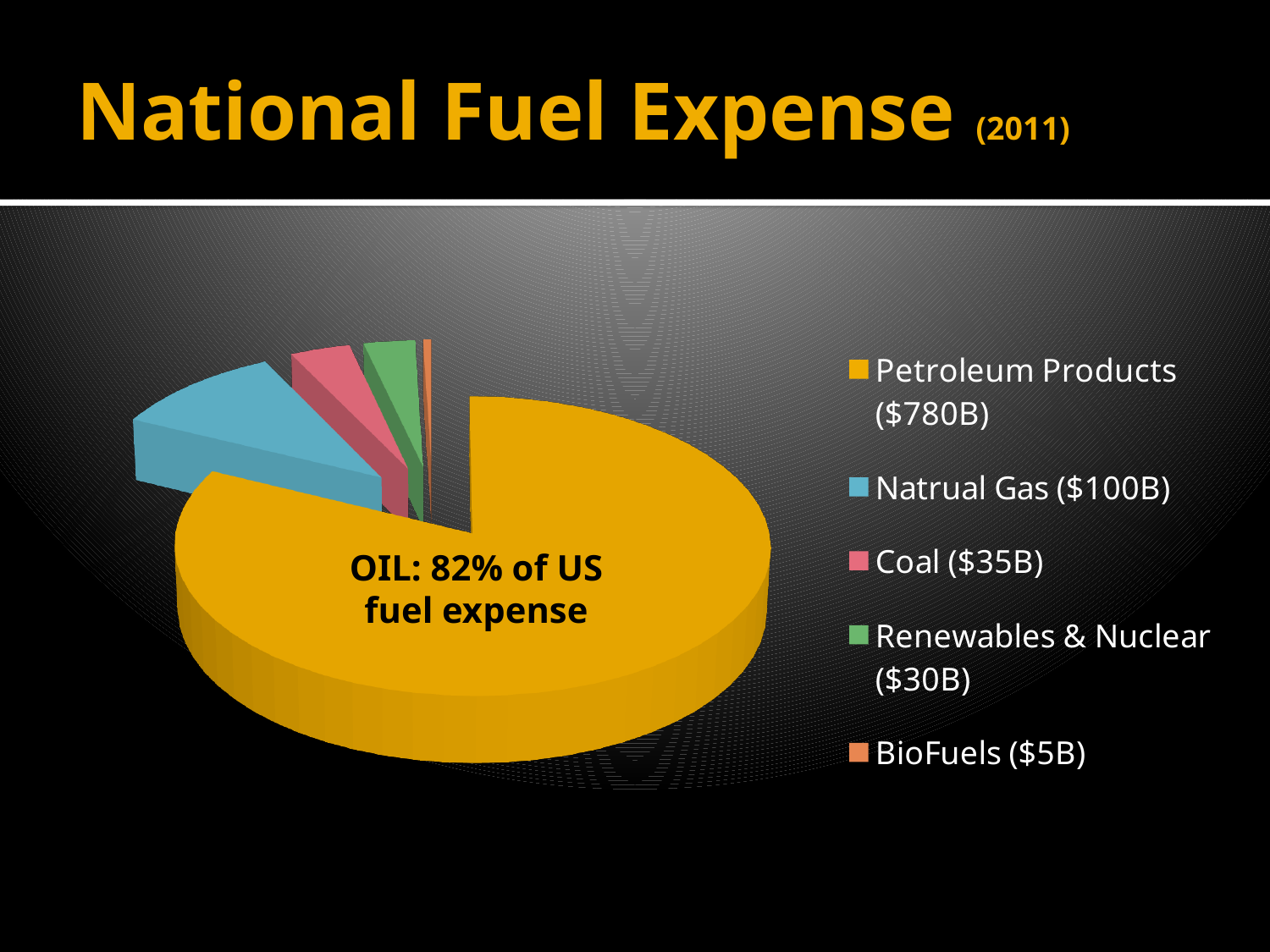
What type of chart is shown on the slide? pie chart How many categories does the legend list? 5 According to the legend, what is the value for BioFuels? $5B Which is larger, the value for Coal or the value for Renewables & Nuclear? Coal What share of US fuel expense does the oil slice represent, according to the label on the chart? 82% According to the legend, what is the value for Coal? $35B According to the legend, what is the value for Petroleum Products? $780B According to the legend, what is the value for Natural Gas? $100B Which category has the largest slice of the pie? Petroleum Products What is the difference between the Petroleum Products value and the Natural Gas value? $680B According to the legend, what is the value for Renewables & Nuclear? $30B Which category has the smallest slice of the pie? BioFuels